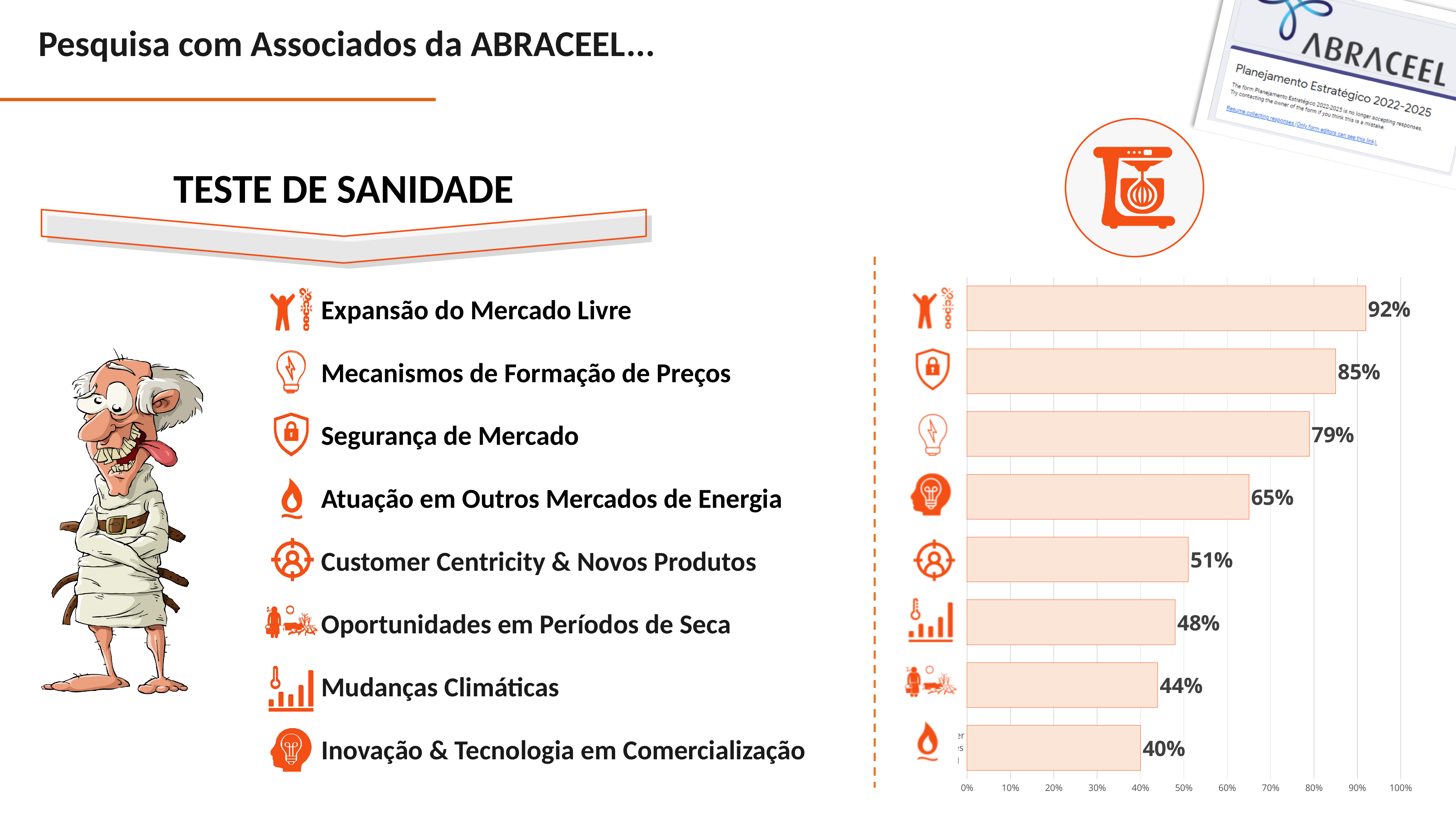
What is the value of the fourth bar from the top in the chart? 65% What is the value of the top bar in the chart (the one with the 'Expansão do Mercado Livre' icon)? 92% Which is larger in the chart: the bar with the thermometer-and-bars icon (48%) or the bar with the drought icon (44%)? the bar with the thermometer-and-bars icon (48%) What is the lowest value shown in the chart? 40% What is the value of the bar with the shield-and-lock icon (Segurança de Mercado)? 85% Do the bar values increase or decrease from the top of the chart to the bottom? decrease How many bars does the chart on the right side of the slide have? 8 What is the difference between the top bar (92%) and the bottom bar (40%) in the chart? 52% What kind of chart is shown on the right side of the slide? bar chart What is the highest value shown in the chart? 92% What is the value of the bottom bar in the chart (the one with the 'Atuação em Outros Mercados de Energia' icon)? 40% What is the value of the bar with the target icon (Customer Centricity & Novos Produtos)? 51%